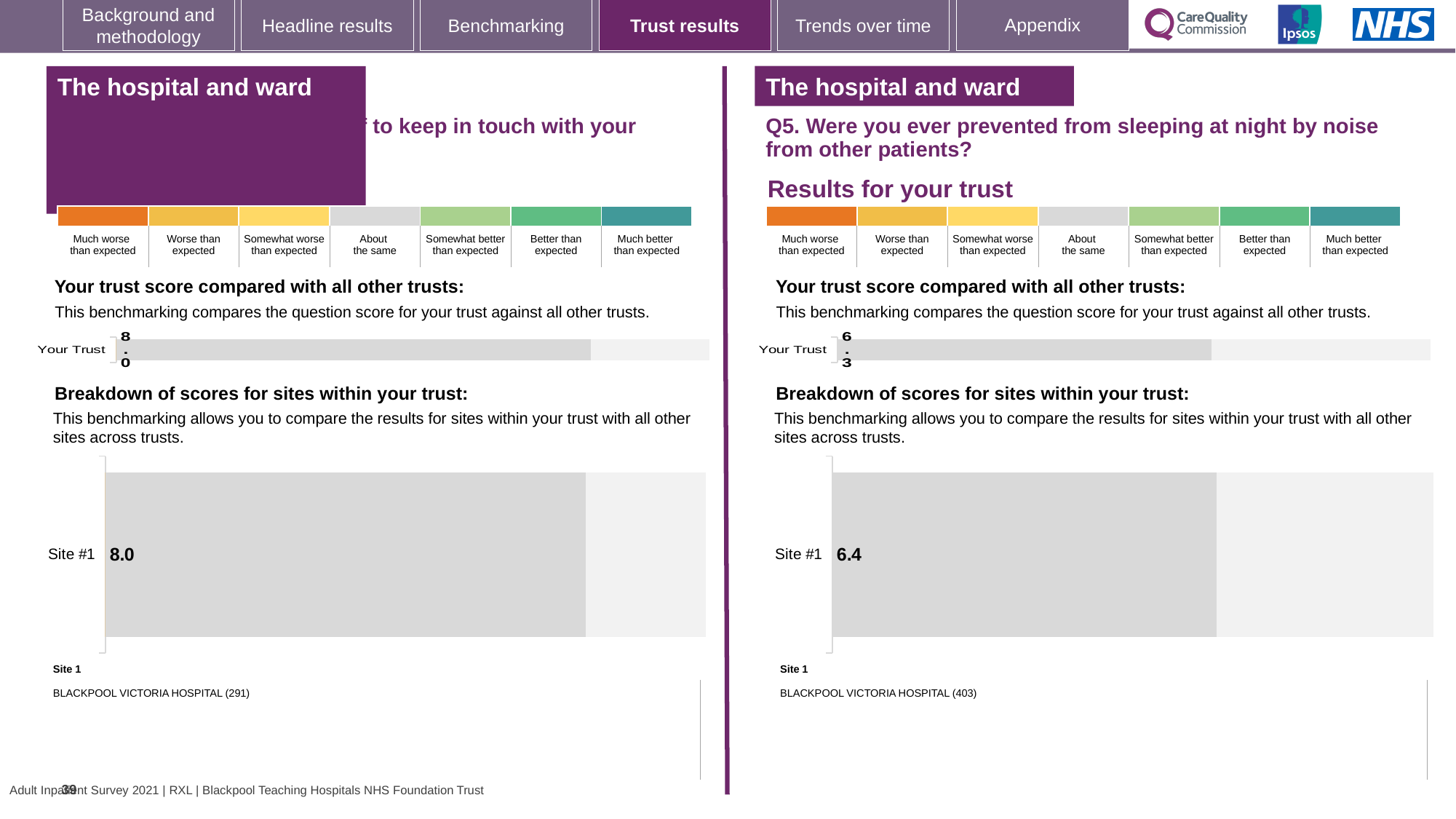
Which site is listed as Site 1 beneath the left-hand breakdown chart? BLACKPOOL VICTORIA HOSPITAL (291) What type of chart is used for the 'Breakdown of scores for sites within your trust' on the right-hand side? Bar chart How many sites are plotted in the left-hand 'Breakdown of scores for sites within your trust' chart? 1 On the left-hand side, what is the value shown for Your Trust in the 'Your trust score compared with all other trusts' chart? 8.0 On the right-hand side (Q5), what score is shown for Site #1 in the 'Breakdown of scores for sites within your trust' chart? 6.4 Which site is listed as Site 1 beneath the right-hand breakdown chart? BLACKPOOL VICTORIA HOSPITAL (403) How many sites are plotted in the right-hand 'Breakdown of scores for sites within your trust' chart? 1 Which is larger: the Site #1 score in the left-hand breakdown chart or the Site #1 score in the right-hand breakdown chart? Left-hand (8.0) What is the difference between the Site #1 score in the left-hand breakdown chart (8.0) and the Site #1 score in the right-hand breakdown chart (6.4)? 1.6 On the right-hand side (Q5), what is the value shown for Your Trust in the 'Your trust score compared with all other trusts' chart? 6.3 On the right-hand side (Q5), what is the difference between the Site #1 score (6.4) and the Your Trust score (6.3)? 0.1 On the left-hand side, what score is shown for Site #1 in the 'Breakdown of scores for sites within your trust' chart? 8.0